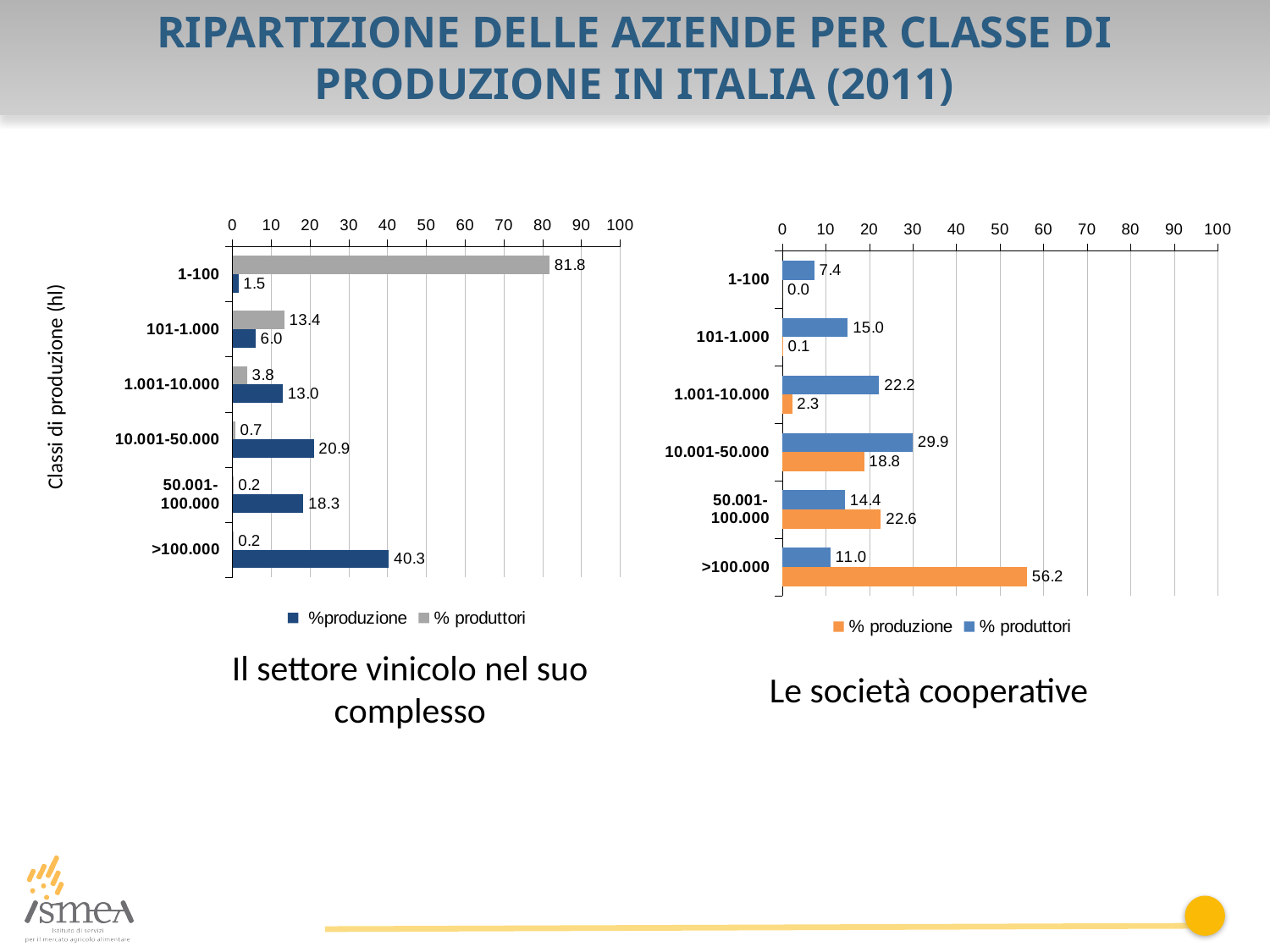
In the chart 'Il settore vinicolo nel suo complesso', which production class has the highest %produzione value? >100.000 In the chart 'Le società cooperative', which production class has the lowest % produttori value? 1-100 How many series does the legend of the chart 'Il settore vinicolo nel suo complesso' list? 2 In the chart 'Le società cooperative', what is the difference between the % produzione and % produttori values for the 50.001-100.000 class? 8.2 How many production classes are shown in the chart 'Le società cooperative'? 6 In the chart 'Il settore vinicolo nel suo complesso', what is the % produttori value for the 1-100 class? 81.8 In the chart 'Il settore vinicolo nel suo complesso', which is larger for the 101-1.000 class: %produzione or % produttori? % produttori What type of chart is 'Le società cooperative'? Bar chart In the chart 'Le società cooperative', what is the % produzione value for the >100.000 class? 56.2 In the chart 'Le società cooperative', what is the % produttori value for the 10.001-50.000 class? 29.9 In the chart 'Il settore vinicolo nel suo complesso', what is the %produzione value for the >100.000 class? 40.3 In the chart 'Le società cooperative', what colour represents the % produzione series? Orange